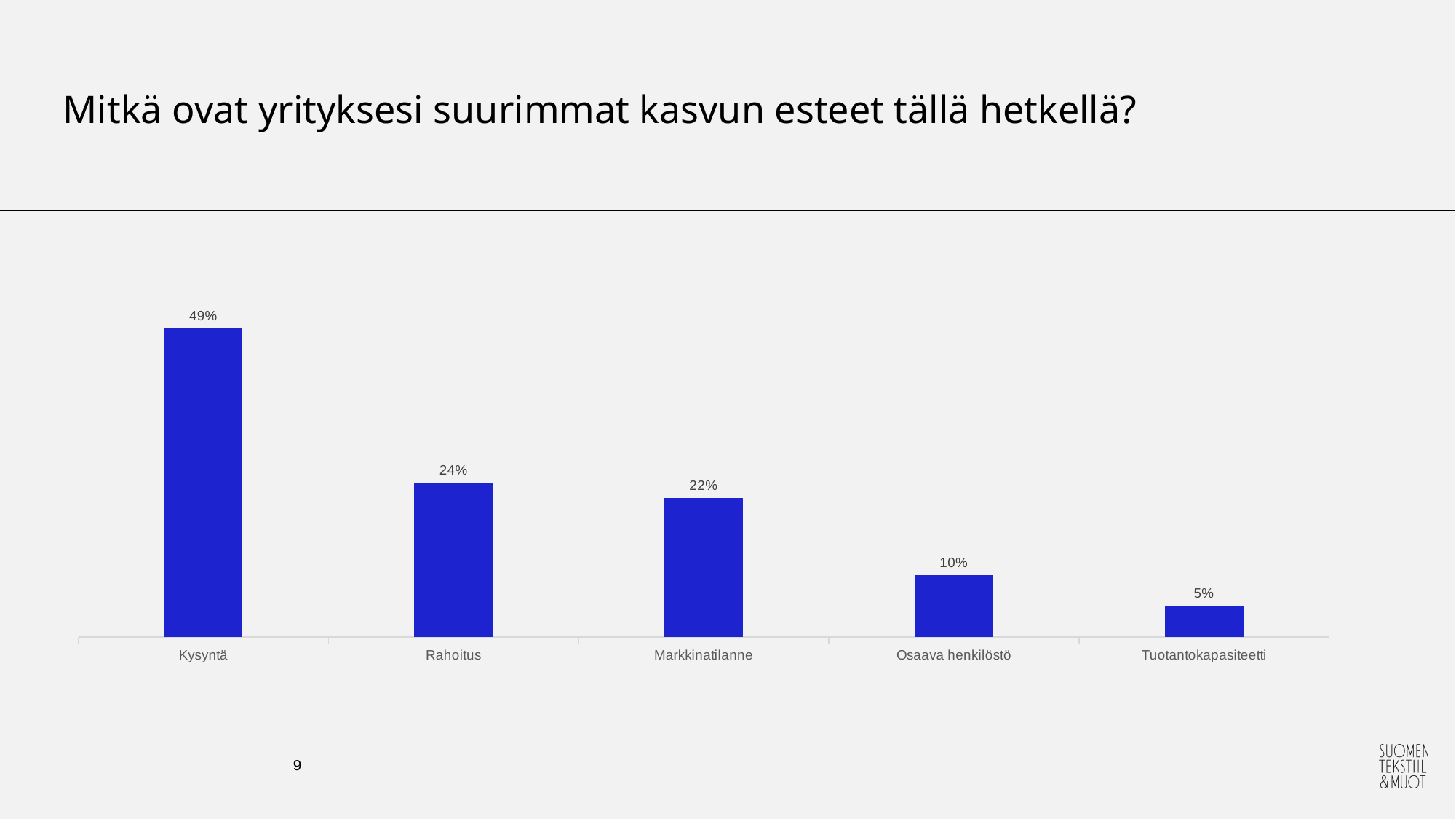
Which is larger, the value for Rahoitus or the value for Osaava henkilöstö? Rahoitus What is the value for Markkinatilanne? 22% What is the value for Osaava henkilöstö? 10% What is the value for Tuotantokapasiteetti? 5% Which category has the lowest value? Tuotantokapasiteetti What kind of chart is shown on the slide? Bar chart Which category has the highest value? Kysyntä What is the difference between the values for Osaava henkilöstö and Tuotantokapasiteetti? 5% How many categories are shown in the chart? 5 What is the difference between the values for Kysyntä and Rahoitus? 25% What is the value for Kysyntä? 49% What is the value for Rahoitus? 24%